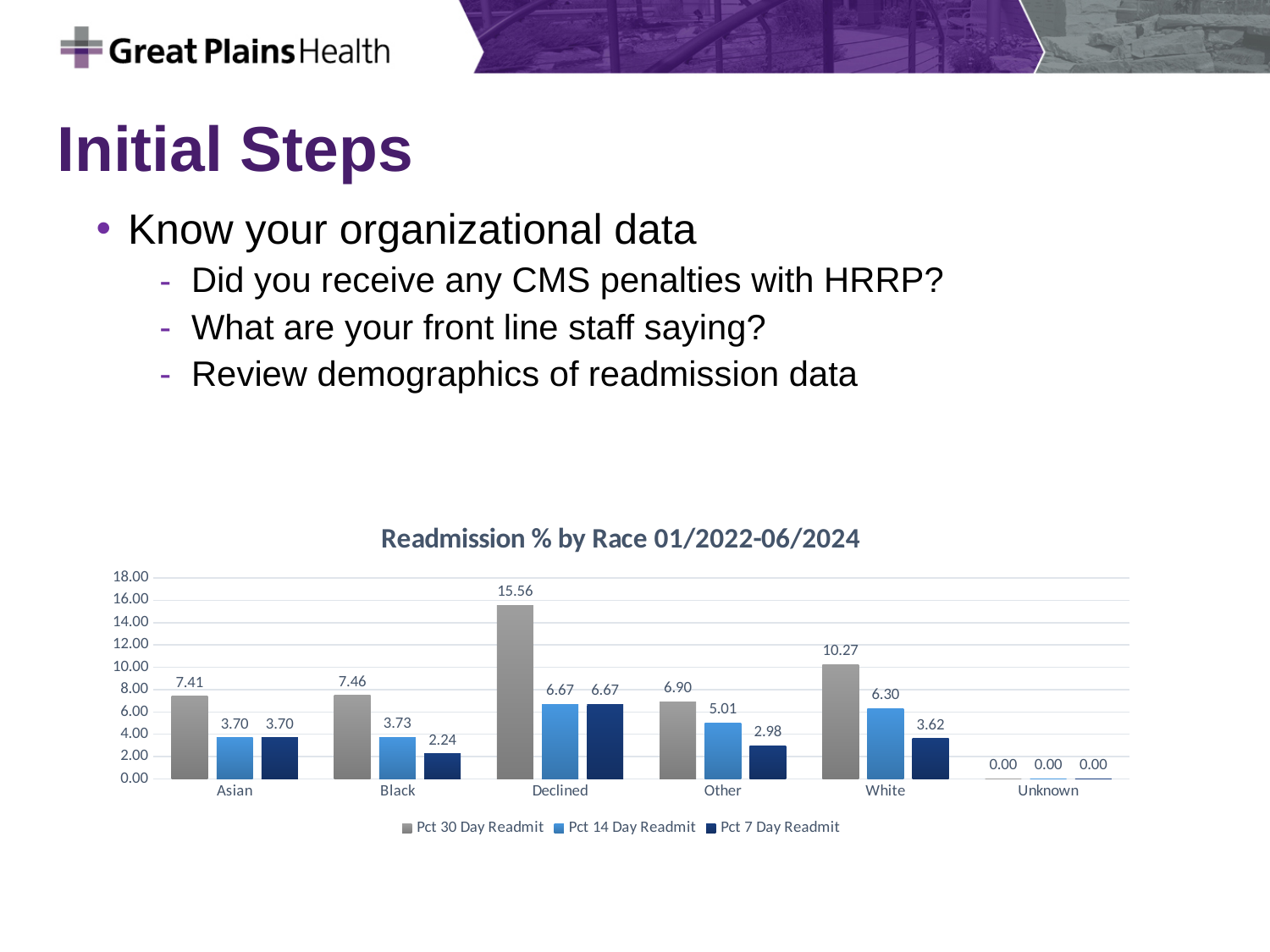
How many race categories are shown on the x axis? 6 How many series does the legend list? 3 Which is larger, the Pct 14 Day Readmit value for Other or for Asian? Other What is the Pct 7 Day Readmit value for Black? 2.24 What is the title of the chart? Readmission % by Race 01/2022-06/2024 What is the difference between the Pct 14 Day Readmit and Pct 7 Day Readmit values for Other? 2.03 What is the difference between the Pct 30 Day Readmit values for Declined and White? 5.29 What kind of chart is shown on the slide? Bar chart What is the Pct 14 Day Readmit value for White? 6.30 What is the Pct 30 Day Readmit value for Declined? 15.56 Which race category has the highest Pct 30 Day Readmit value? Declined Which race category has the lowest Pct 7 Day Readmit value? Unknown